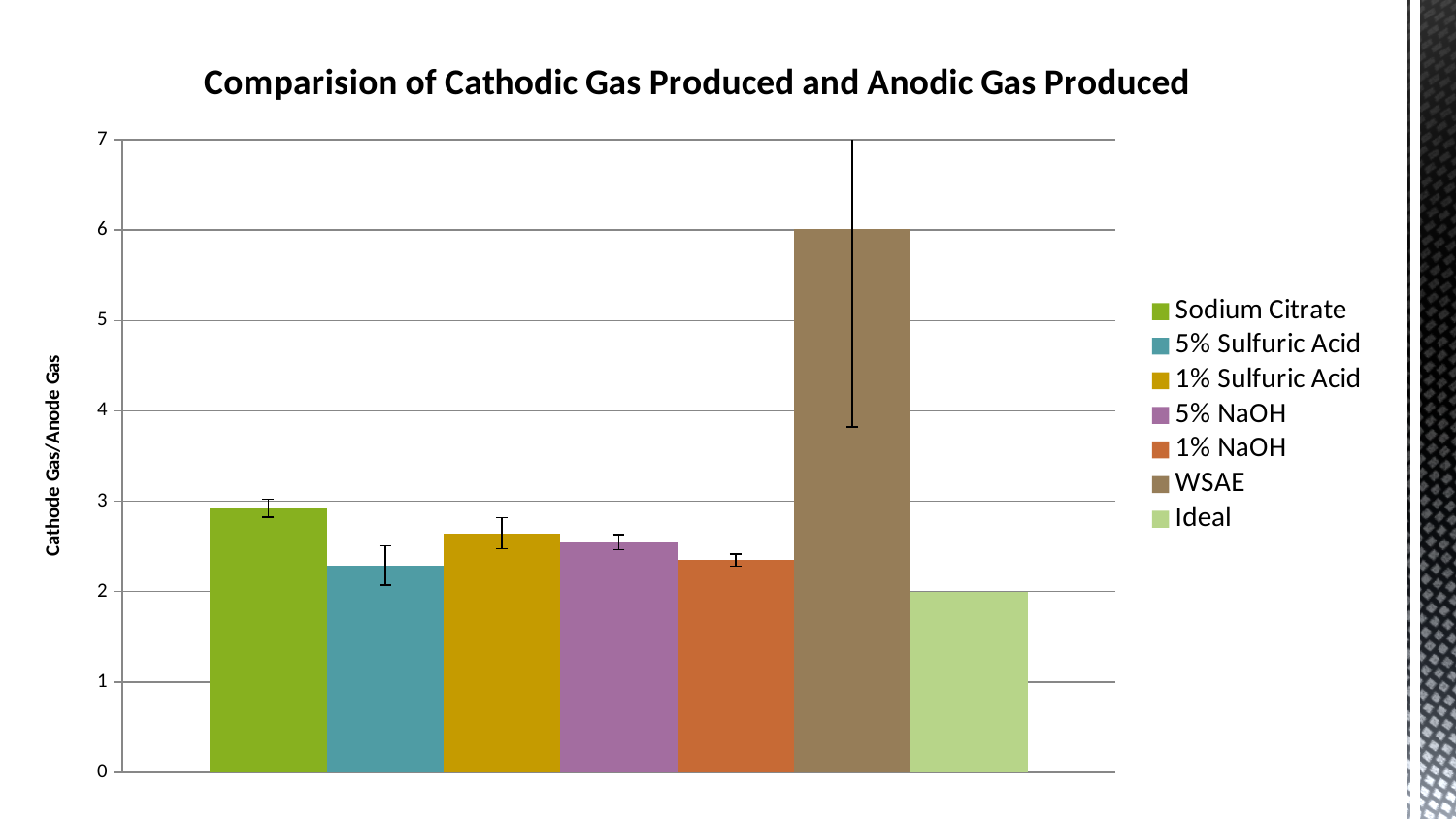
How many bars are plotted in the chart? 7 What is the value for Ideal? 2 What is the label of the vertical axis? Cathode Gas/Anode Gas Which category has the highest value? WSAE How many entries does the legend list? 7 What is the title of the chart? Comparision of Cathodic Gas Produced and Anodic Gas Produced Which is larger, the value for Sodium Citrate or the value for 5% Sulfuric Acid? Sodium Citrate What type of chart is shown on the slide? bar chart Which category has the lowest value? Ideal Is the value for Sodium Citrate greater or less than 3? less